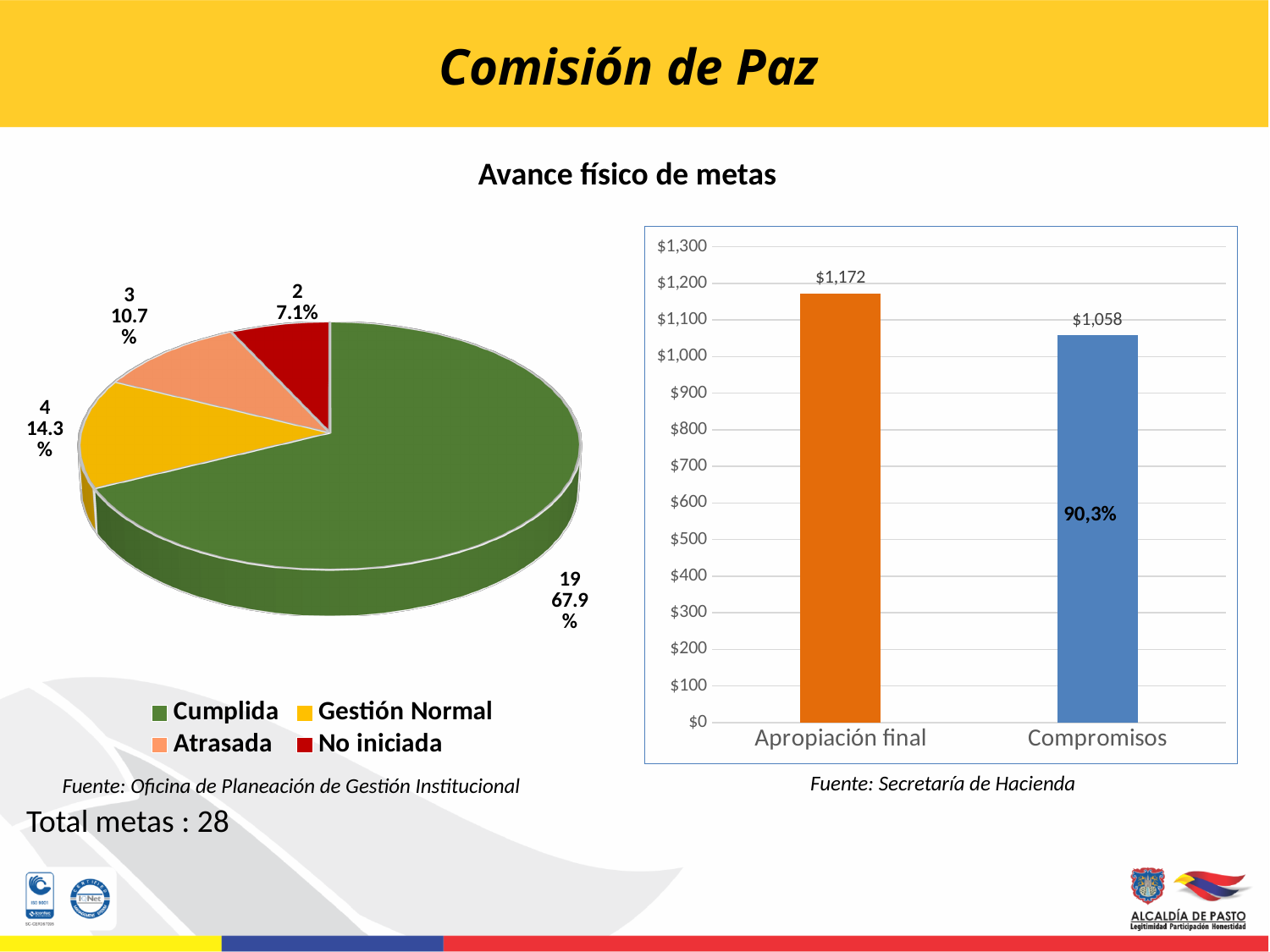
In the bar chart on the right, what is the difference between Apropiación final and Compromisos? $114 In the bar chart on the right, what is the value for Compromisos? $1,058 In the bar chart on the right, what is the value for Apropiación final? $1,172 What kind of chart is shown on the right side of the slide? Bar chart In the pie chart on the left, which category has the largest slice? Cumplida In the pie chart on the left, which category has the smallest slice? No iniciada In the pie chart on the left, how many categories does the legend list? 4 In the pie chart on the left, what percentage share does the Cumplida slice show? 67.9% In the pie chart on the left, how many metas are labelled Cumplida? 19 In the pie chart on the left, how many more metas are Gestión Normal than No iniciada? 2 In the pie chart on the left, which colour represents Gestión Normal? Yellow In the pie chart on the left, what percentage is shown for the Atrasada slice? 10.7%